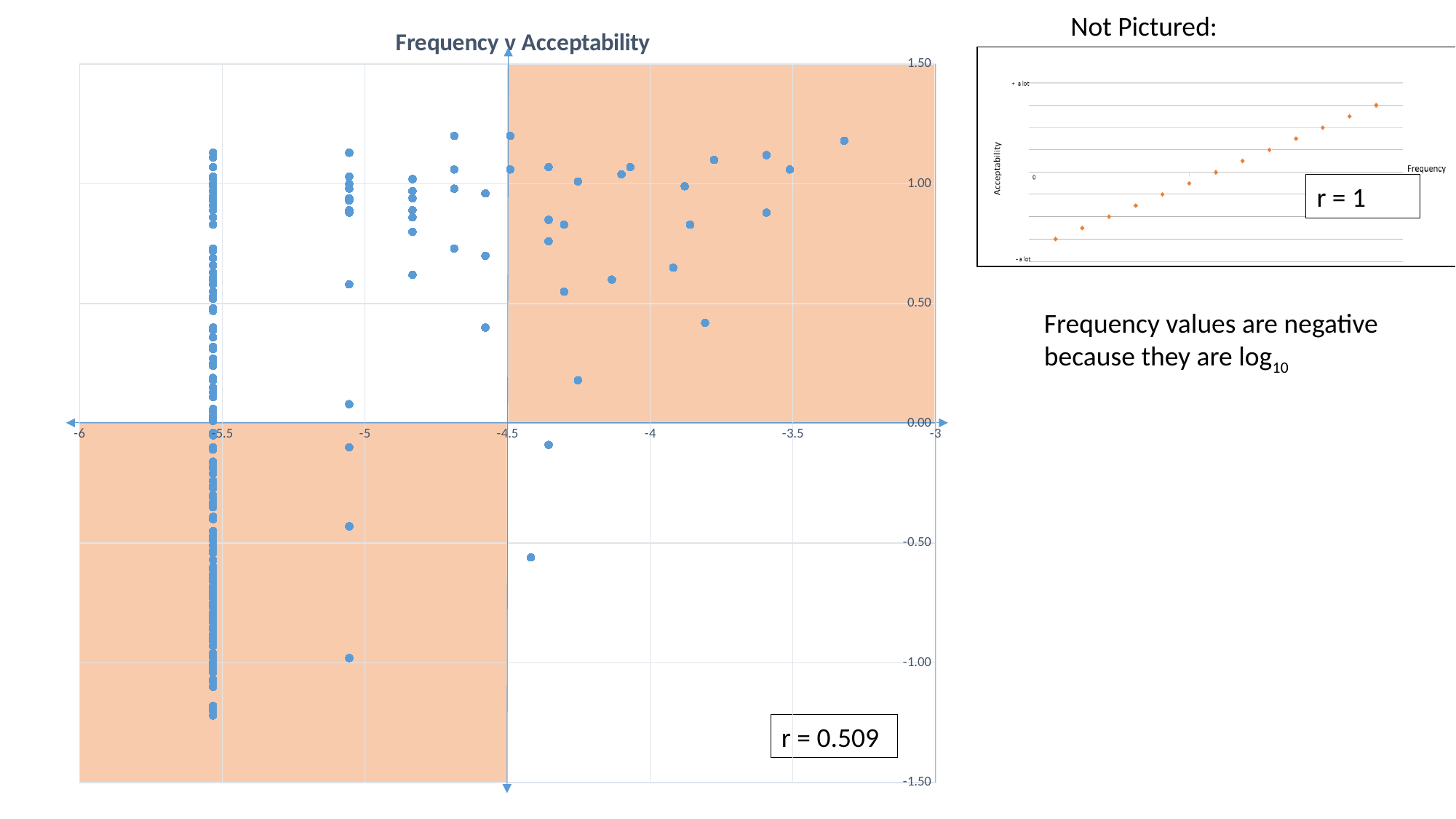
What kind of chart is the Frequency v Acceptability chart? Scatter chart What is the highest value shown on the y axis of the Frequency v Acceptability chart? 1.50 What correlation value (r) is shown on the small 'Not Pictured' chart on the right? r = 1 What correlation value (r) is shown on the Frequency v Acceptability chart? r = 0.509 What is the lowest value shown on the x axis of the Frequency v Acceptability chart? -6 What is the y-axis label of the small 'Not Pictured' chart? Acceptability What is the title of the large chart on the left? Frequency v Acceptability How many charts are shown on the slide? 2 In the Frequency v Acceptability chart, is the highest plotted point greater or less than 1.00 on the y axis? greater In the Frequency v Acceptability chart, is the lowest plotted point greater or less than -1.00 on the y axis? less In the small 'Not Pictured' chart, do the points rise or fall as Frequency increases? Rise In the Frequency v Acceptability chart, do acceptability values generally rise or fall as frequency increases? Rise